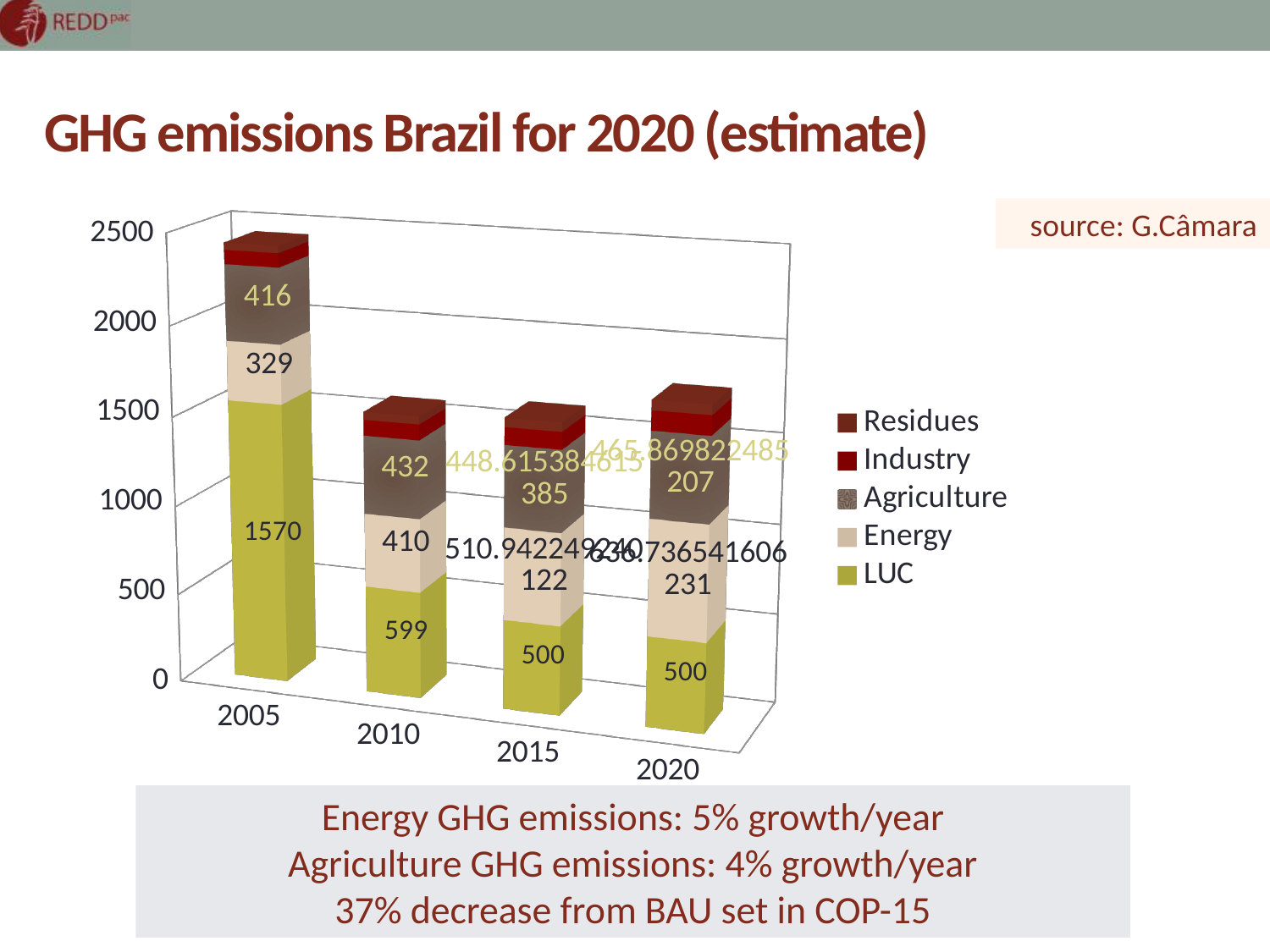
What is the Agriculture value for 2005? 416 What is the Energy value for 2010? 410 Which series is listed first (at the top) in the legend? Residues What is the Energy value for 2005? 329 What is the difference between the LUC value in 2005 and the LUC value in 2010? 971 What is the LUC value for 2010? 599 What is the LUC value for 2005? 1570 Is the total for 2005 greater or less than 2000? greater Which year has the tallest total bar? 2005 How many years are shown on the x axis? 4 What kind of chart is shown on the slide? Stacked bar chart How many series does the legend list? 5